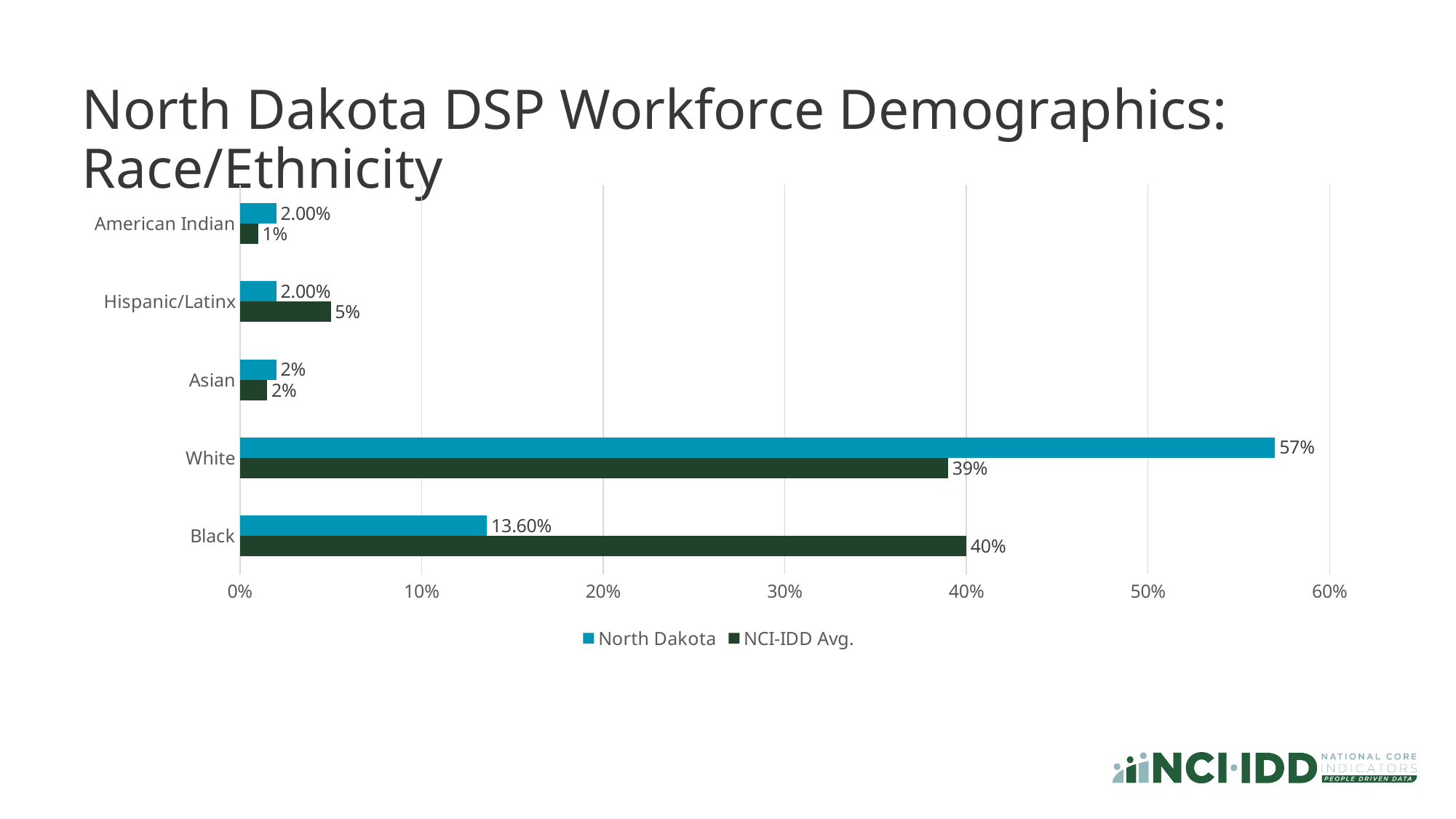
Which category has the lowest NCI-IDD Avg. value? American Indian What is the NCI-IDD Avg. value for White? 39% How many series does the legend list? 2 Is the North Dakota value for White greater or less than 50%? greater How many race/ethnicity categories are shown on the chart? 5 Which category has the highest North Dakota value? White What is the NCI-IDD Avg. value for Hispanic/Latinx? 5% What is the difference between the North Dakota and NCI-IDD Avg. values for White? 18% What kind of chart is shown on the slide? Bar chart Which is larger for Black: the North Dakota value or the NCI-IDD Avg. value? NCI-IDD Avg. What is the North Dakota value for American Indian? 2.00% What is the North Dakota value for Black? 13.60%